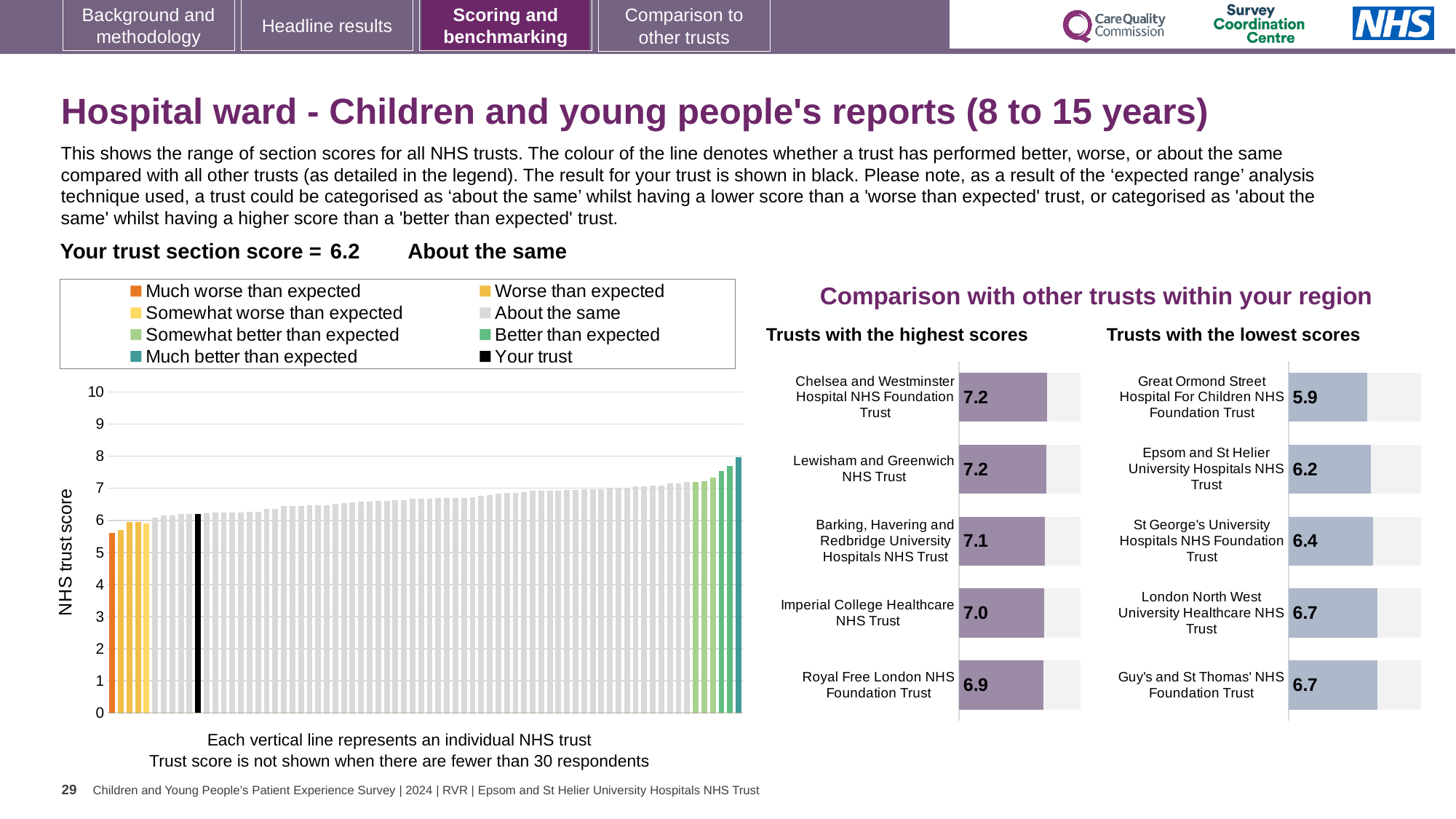
In the 'Trusts with the highest scores' chart, what is the difference between the scores of Chelsea and Westminster Hospital NHS Foundation Trust and Royal Free London NHS Foundation Trust? 0.3 In the 'Trusts with the highest scores' chart, what is the score for Imperial College Healthcare NHS Trust? 7.0 In the 'Trusts with the highest scores' chart, which has the higher score: Barking, Havering and Redbridge University Hospitals NHS Trust or Imperial College Healthcare NHS Trust? Barking, Havering and Redbridge University Hospitals NHS Trust In the NHS trust score chart on the left, do the bars rise or fall from left to right? Rise In the 'Trusts with the lowest scores' chart, what is the score for Great Ormond Street Hospital For Children NHS Foundation Trust? 5.9 How many entries does the legend of the NHS trust score chart on the left list? 8 In the 'Trusts with the lowest scores' chart, which trust has the lowest score? Great Ormond Street Hospital For Children NHS Foundation Trust In the 'Trusts with the lowest scores' chart, what is the difference between the scores of Guy's and St Thomas' NHS Foundation Trust and Great Ormond Street Hospital For Children NHS Foundation Trust? 0.8 In the 'Trusts with the highest scores' chart, which trust has the lowest score? Royal Free London NHS Foundation Trust How many trusts are shown in the 'Trusts with the highest scores' chart? 5 What kind of chart is the NHS trust score chart on the left of the slide? Bar chart In the NHS trust score chart on the left, is the value of the rightmost bar greater or less than 7? greater